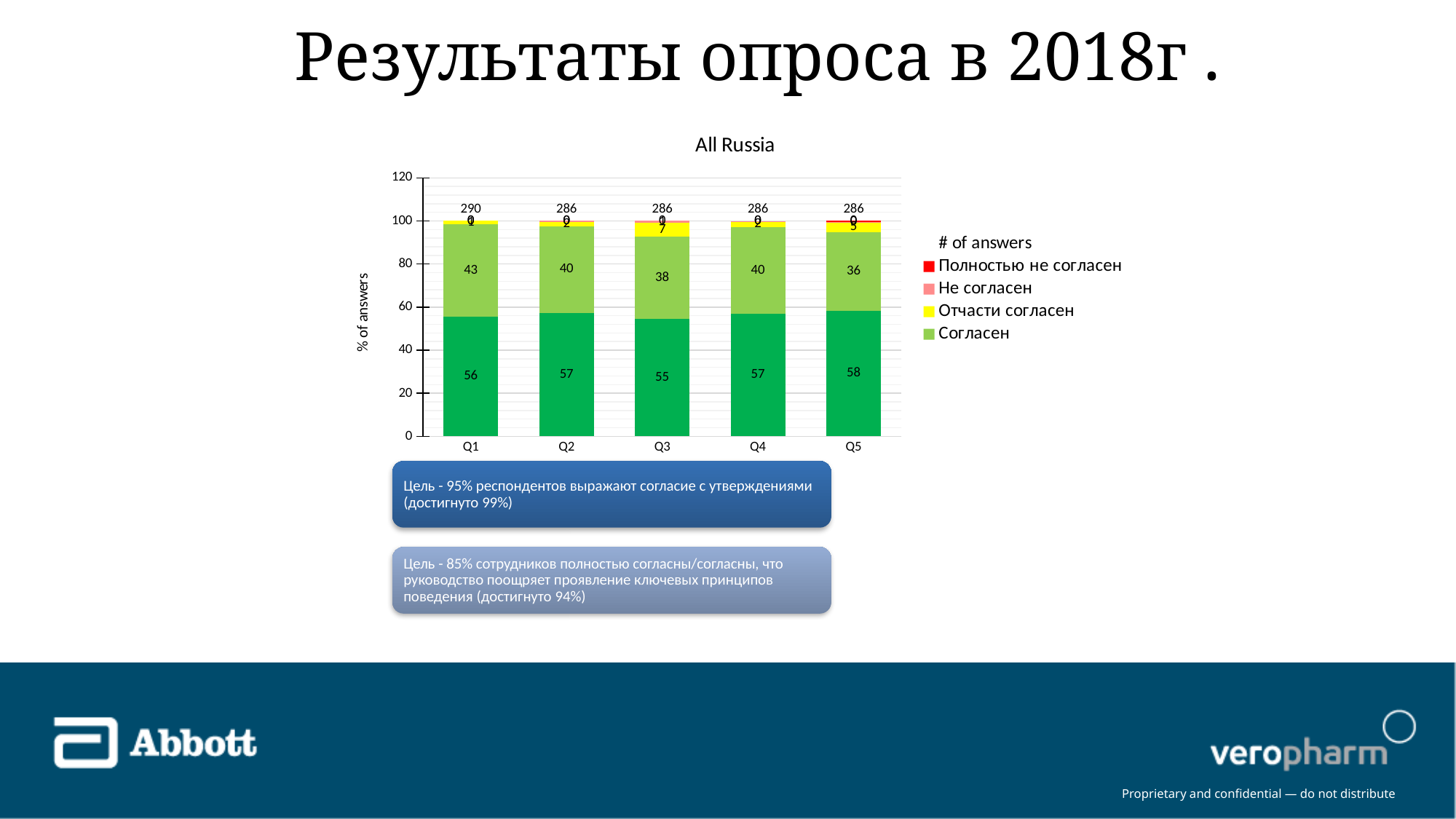
Which category has the highest 'Согласен' value? Q1 What is the title of the chart? All Russia What is the value of the 'Согласен' segment for Q3? 38 Which has the larger 'Согласен' value, Q2 or Q3? Q2 What is the value of the bottom dark green segment for Q5? 58 Which category has the lowest 'Согласен' value? Q5 What is the value of the 'Отчасти согласен' segment for Q3? 7 Which category has the highest value for the bottom dark green segment? Q5 How many categories are shown on the x axis of the chart? 5 What type of chart is shown on the slide? Stacked bar chart What number is printed above the Q1 bar? 290 What is the difference between the 'Согласен' values for Q1 and Q5? 7